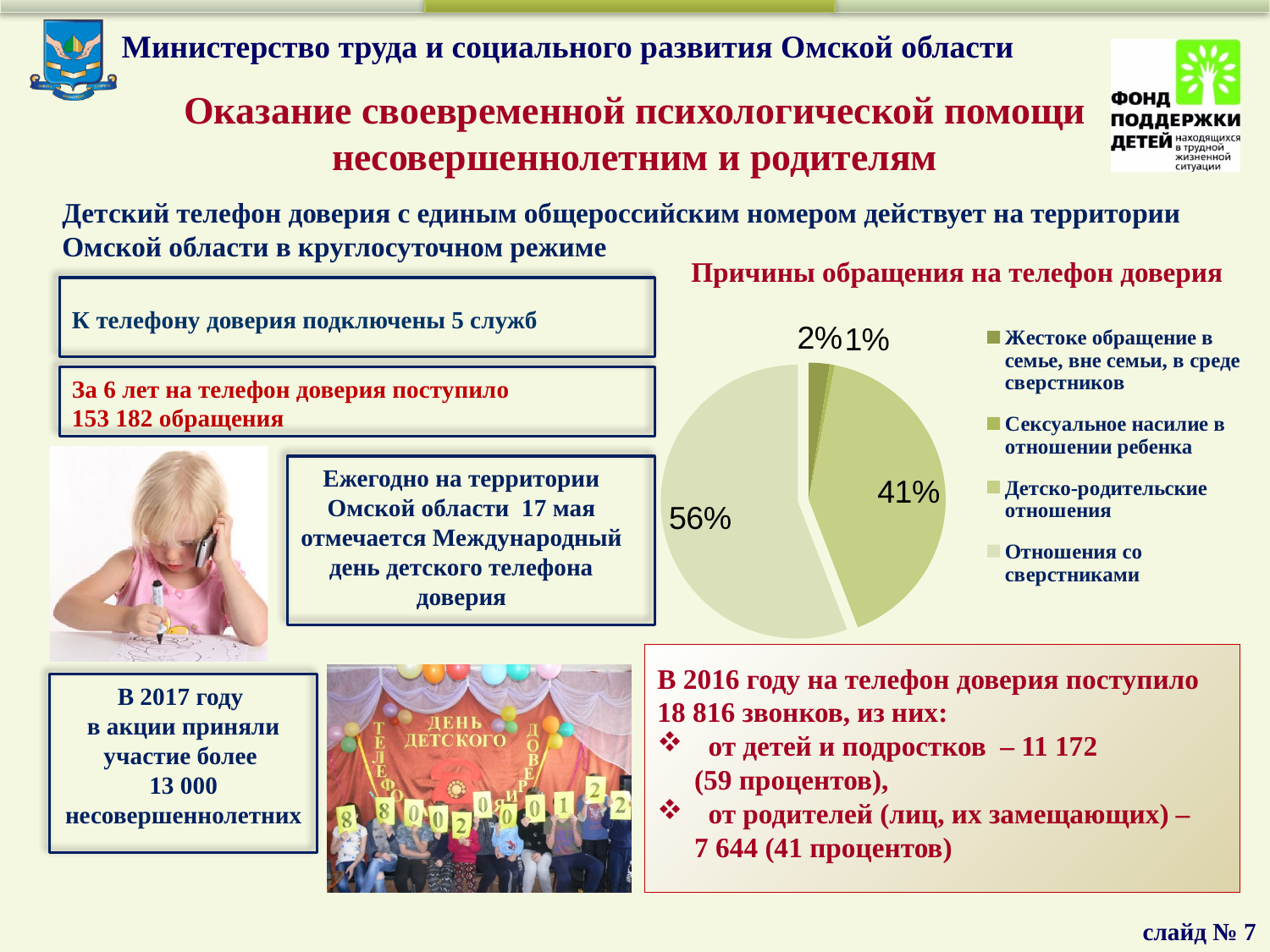
What is the title of the pie chart on the slide? Причины обращения на телефон доверия In the pie chart "Причины обращения на телефон доверия", what share is labelled for "Детско-родительские отношения"? 41% In the pie chart "Причины обращения на телефон доверия", what is the combined share of "Жестоке обращение в семье, вне семьи, в среде сверстников" and "Сексуальное насилие в отношении ребенка"? 3% In the pie chart "Причины обращения на телефон доверия", what share is labelled for "Отношения со сверстниками"? 56% In the pie chart "Причины обращения на телефон доверия", what is the difference in percentage points between "Отношения со сверстниками" and "Детско-родительские отношения"? 15 In the pie chart "Причины обращения на телефон доверия", which category has the largest slice? Отношения со сверстниками In the pie chart "Причины обращения на телефон доверия", what share is labelled for "Сексуальное насилие в отношении ребенка"? 1% In the pie chart "Причины обращения на телефон доверия", which category has the smallest slice? Сексуальное насилие в отношении ребенка In the pie chart "Причины обращения на телефон доверия", which is larger: the slice for "Детско-родительские отношения" or the slice for "Отношения со сверстниками"? Отношения со сверстниками In the pie chart "Причины обращения на телефон доверия", how many categories does the legend list? 4 In the pie chart "Причины обращения на телефон доверия", what share is labelled for "Жестоке обращение в семье, вне семьи, в среде сверстников"? 2% What kind of chart is shown under the title "Причины обращения на телефон доверия"? pie chart